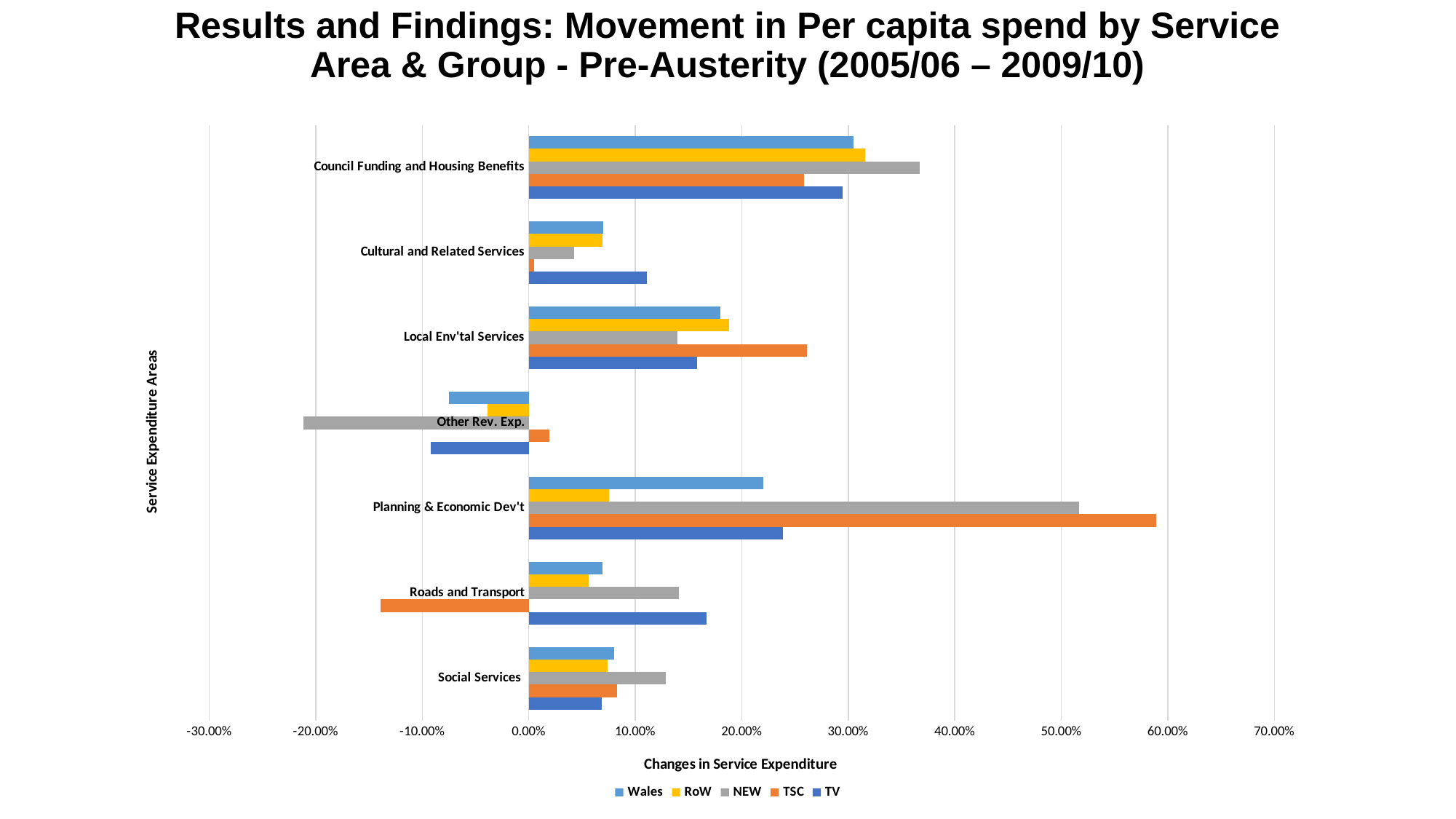
Is the NEW value for Council Funding and Housing Benefits greater or less than 30.00%? greater How many service expenditure areas are plotted on the chart? 7 Is the NEW value for Other Rev. Exp. greater or less than -20.00%? less Which series has the highest value for Council Funding and Housing Benefits? NEW Which service expenditure area has the highest TSC value? Planning & Economic Dev't What is the title of the horizontal axis? Changes in Service Expenditure For Planning & Economic Dev't, which is larger, the NEW value or the Wales value? NEW Is the TSC value for Planning & Economic Dev't greater or less than 50.00%? greater How many series does the legend list? 5 For Roads and Transport, which is larger, the TV value or the TSC value? TV Which service expenditure area has the lowest NEW value? Other Rev. Exp. What kind of chart is shown on the slide? bar chart